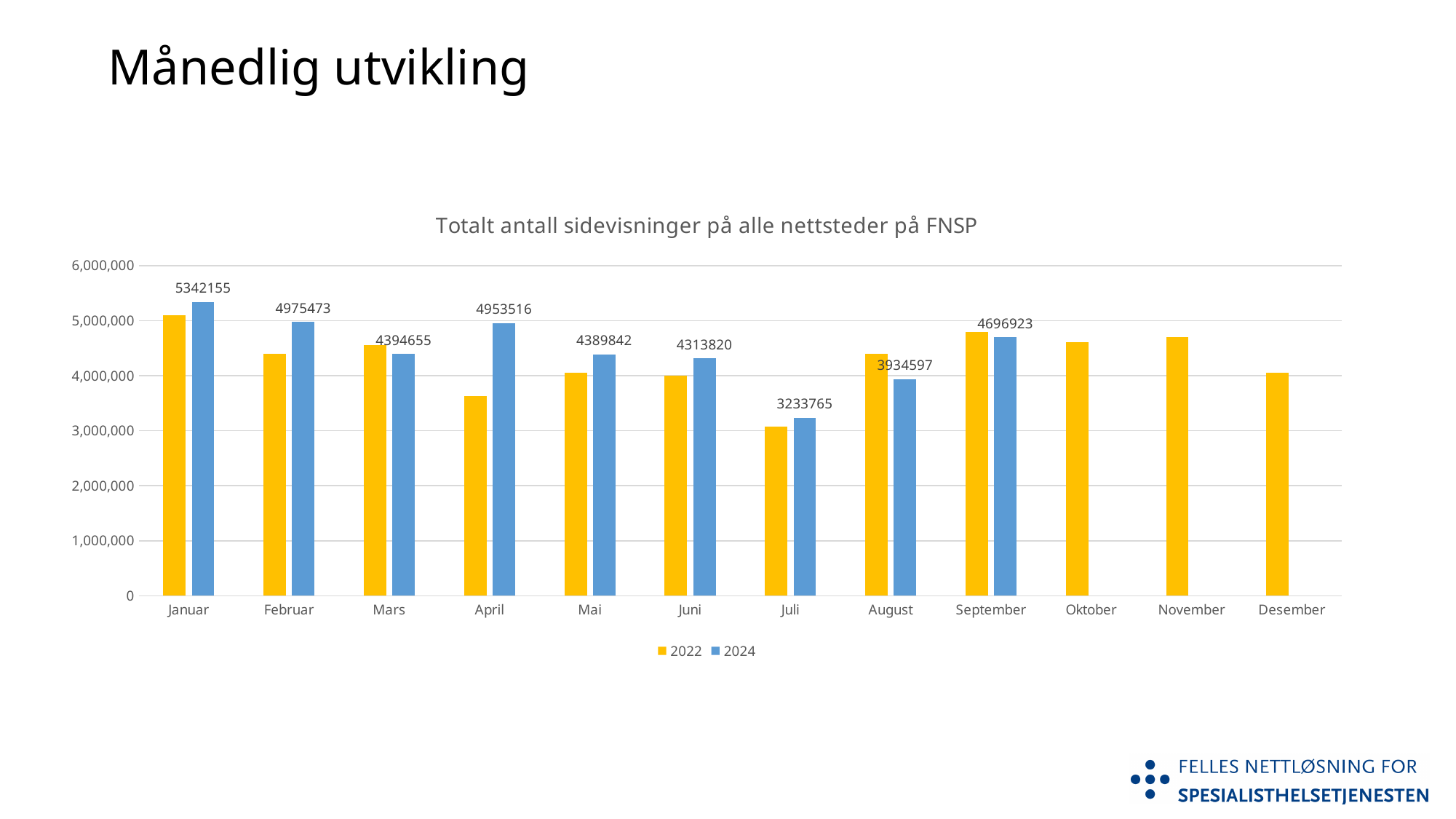
What is the value for 2024 in September? 4696923 What is the difference between the 2024 values for Januar and Februar? 366682 What is the value for 2024 in Juli? 3233765 Is the value for 2022 in April greater or less than 4,000,000? less What is the value for 2024 in Januar? 5342155 Which month has the lowest value for the 2024 series? Juli Is the value for 2022 in Januar greater or less than 5,000,000? greater What kind of chart is shown on the slide? Bar chart How many months are shown on the x axis? 12 Which month has the highest value for the 2024 series? Januar How many series does the legend list? 2 Which is larger for the 2024 series: April or Mars? April